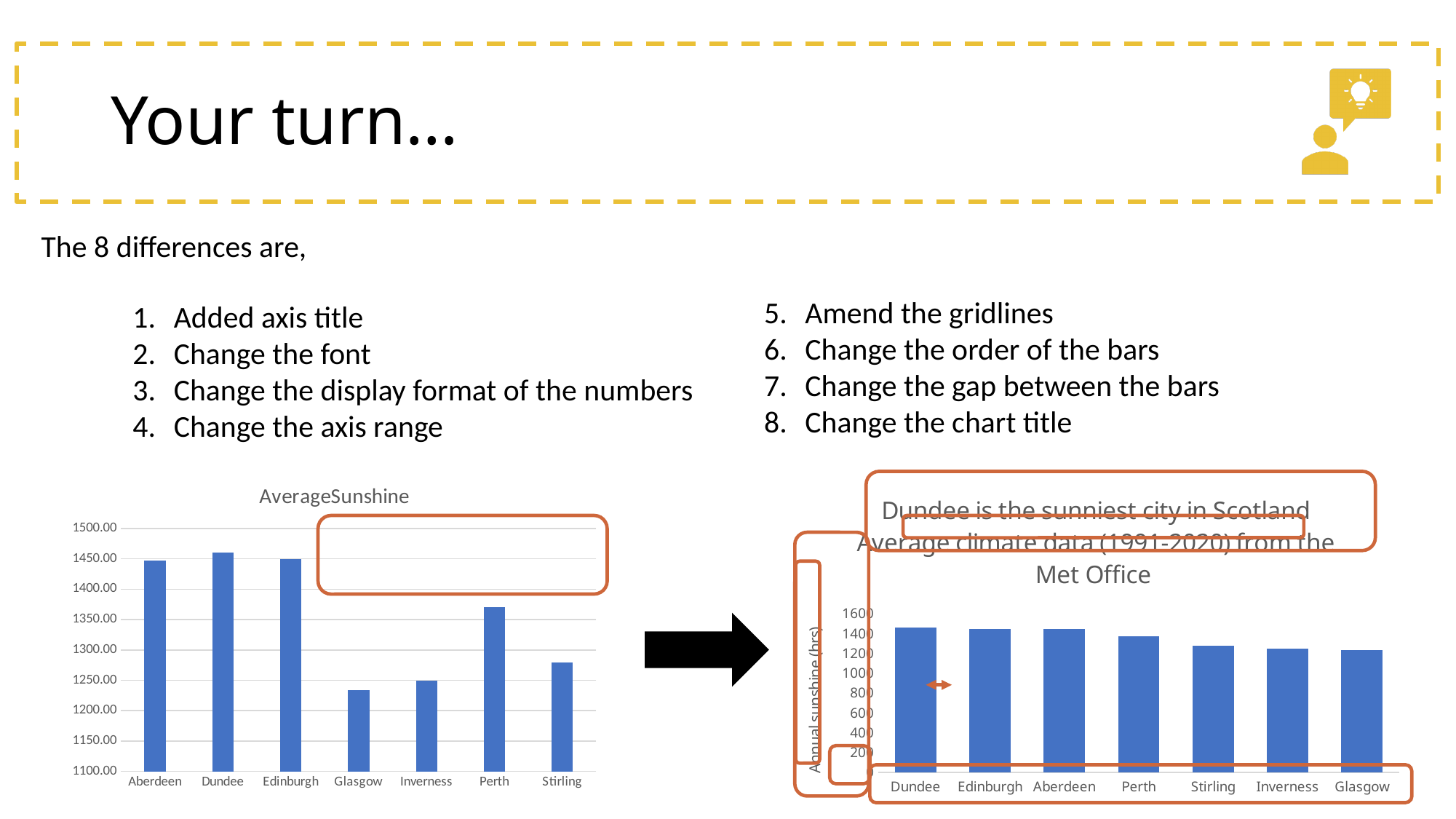
On the left chart titled "AverageSunshine", which has the larger value, Perth or Stirling? Perth On the right chart, which city is listed first on the x axis? Dundee On the left chart titled "AverageSunshine", is the value for Stirling greater or less than 1300? less What is the vertical axis title on the right chart? Annual sunshine (hrs) On the left chart titled "AverageSunshine", is the value for Aberdeen greater or less than 1400? greater On the right chart, is the value for Glasgow greater or less than 1000? greater How many cities are shown on the right chart? 7 On the left chart titled "AverageSunshine", which has the larger value, Edinburgh or Inverness? Edinburgh How many cities are shown on the left chart titled "AverageSunshine"? 7 What kind of chart is the left chart titled "AverageSunshine"? bar chart